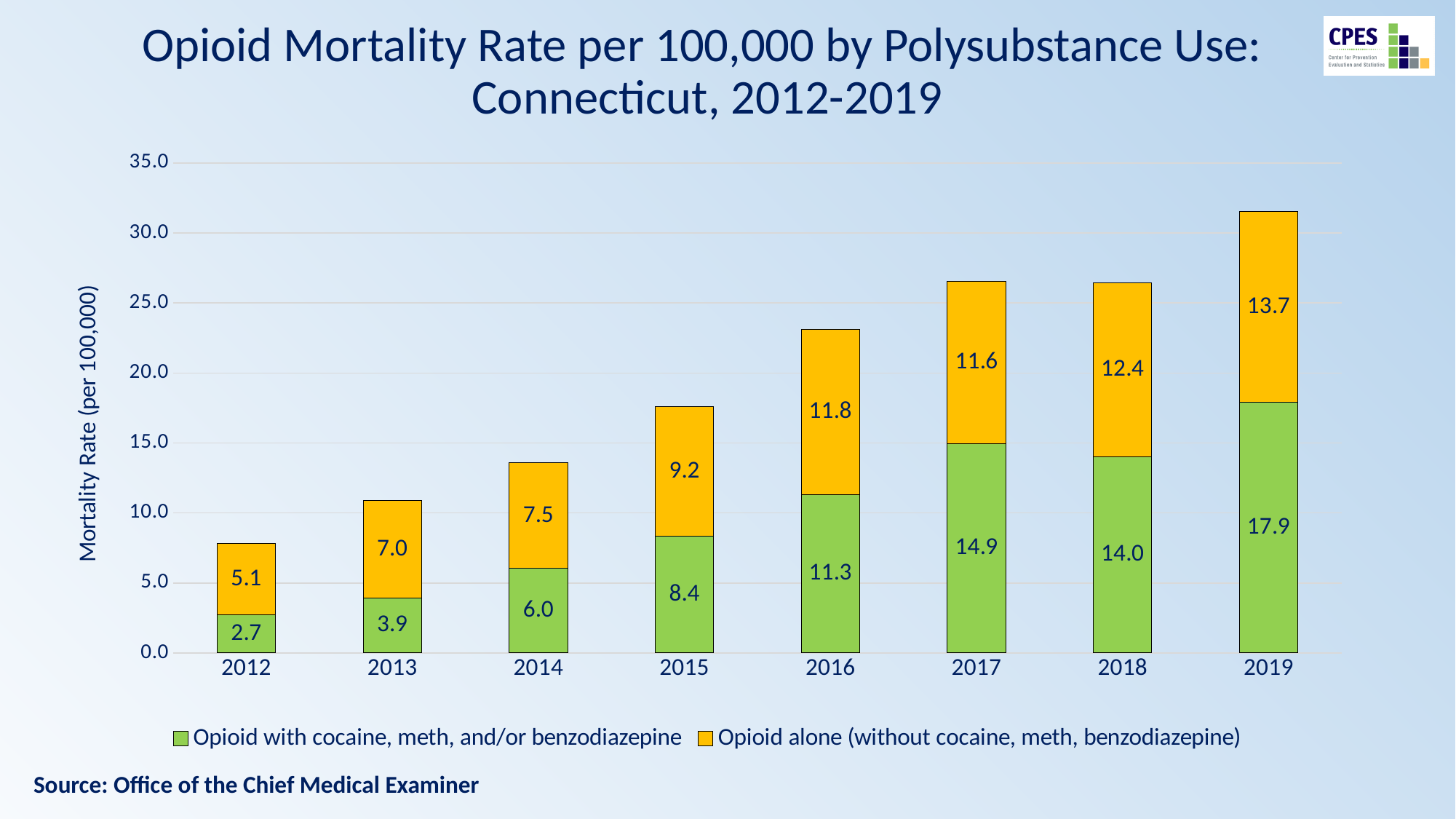
What is the value for 'Opioid alone (without cocaine, meth, benzodiazepine)' in 2013? 7.0 Is the total stacked bar for 2019 greater or less than 30.0? greater What is the total opioid mortality rate for 2015 (sum of both segments)? 17.6 What kind of chart is shown on the slide? Stacked bar chart In 2017, which is larger: 'Opioid with cocaine, meth, and/or benzodiazepine' or 'Opioid alone'? Opioid with cocaine, meth, and/or benzodiazepine Which year has the highest value for 'Opioid with cocaine, meth, and/or benzodiazepine'? 2019 What is the difference between the 'Opioid alone' values for 2019 and 2012? 8.6 What is the opioid mortality rate for 'Opioid with cocaine, meth, and/or benzodiazepine' in 2016? 11.3 How many years are shown on the x axis? 8 What is the label of the y axis? Mortality Rate (per 100,000) Which year has the lowest value for 'Opioid alone (without cocaine, meth, benzodiazepine)'? 2012 How many series does the legend list? 2